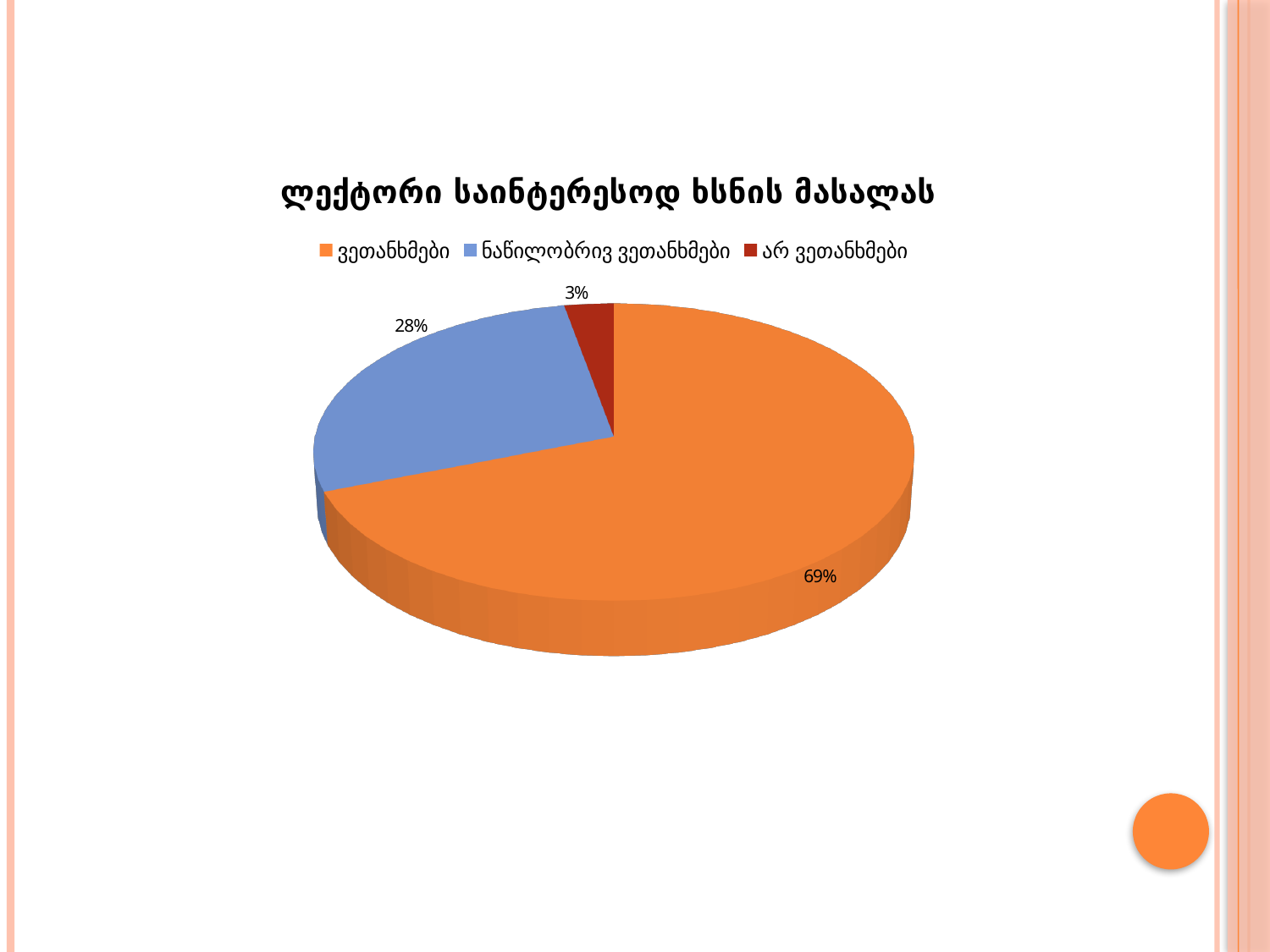
What is the difference in percentage points between ვეთანხმები and ნაწილობრივ ვეთანხმები? 41% What share of the pie is labelled ნაწილობრივ ვეთანხმები? 28% How many entries does the legend list? 3 Which category has the smallest slice of the pie? არ ვეთანხმები Which category has the largest slice of the pie? ვეთანხმები What is the title of the chart? ლექტორი საინტერესოდ ხსნის მასალას Which is larger, the share for ნაწილობრივ ვეთანხმები or the share for არ ვეთანხმები? ნაწილობრივ ვეთანხმები What colour is the slice for არ ვეთანხმები? Dark red What share of the pie is labelled არ ვეთანხმები? 3% What share of the pie is labelled ვეთანხმები? 69% How many slices does the pie chart have? 3 What type of chart is shown on the slide? Pie chart